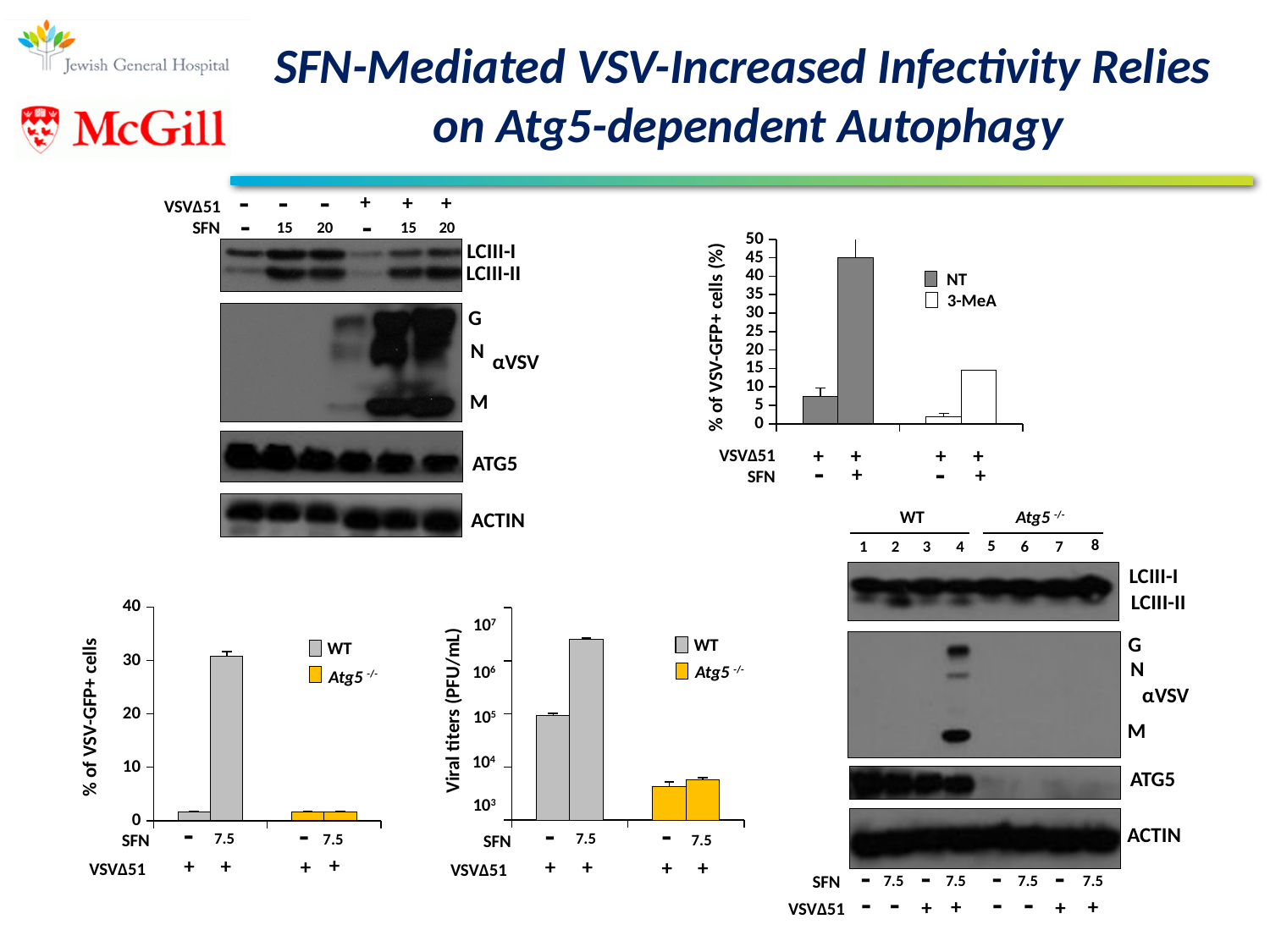
In the bottom-middle chart (Viral titers (PFU/mL)), how many bars are plotted? 4 In the top-right chart (% of VSV-GFP+ cells with NT and 3-MeA), which bar is the highest? NT with SFN + In the top-right chart (% of VSV-GFP+ cells with NT and 3-MeA), how many series does the legend list? 2 In the bottom-left chart (% of VSV-GFP+ cells with WT and Atg5-/-), is the value for the WT bar with SFN 7.5 greater or less than 20? greater In the bottom-left chart (% of VSV-GFP+ cells with WT and Atg5-/-), is the value for the Atg5-/- bar with SFN 7.5 greater or less than 10? less In the bottom-left chart (% of VSV-GFP+ cells with WT and Atg5-/-), what colour are the Atg5-/- bars? yellow In the top-right chart (% of VSV-GFP+ cells with NT and 3-MeA), which is larger: the NT bar with SFN + or the 3-MeA bar with SFN +? NT with SFN + In the top-right chart (% of VSV-GFP+ cells with NT and 3-MeA), is the value for the 3-MeA bar with SFN + greater or less than 20? less In the top-right chart (% of VSV-GFP+ cells with NT and 3-MeA), what are the two legend entries? NT and 3-MeA What type of chart is the bottom-left chart (% of VSV-GFP+ cells with WT and Atg5-/-)? bar chart In the bottom-middle chart (Viral titers (PFU/mL)), which is larger: the WT bar with SFN 7.5 or the Atg5-/- bar with SFN 7.5? WT with SFN 7.5